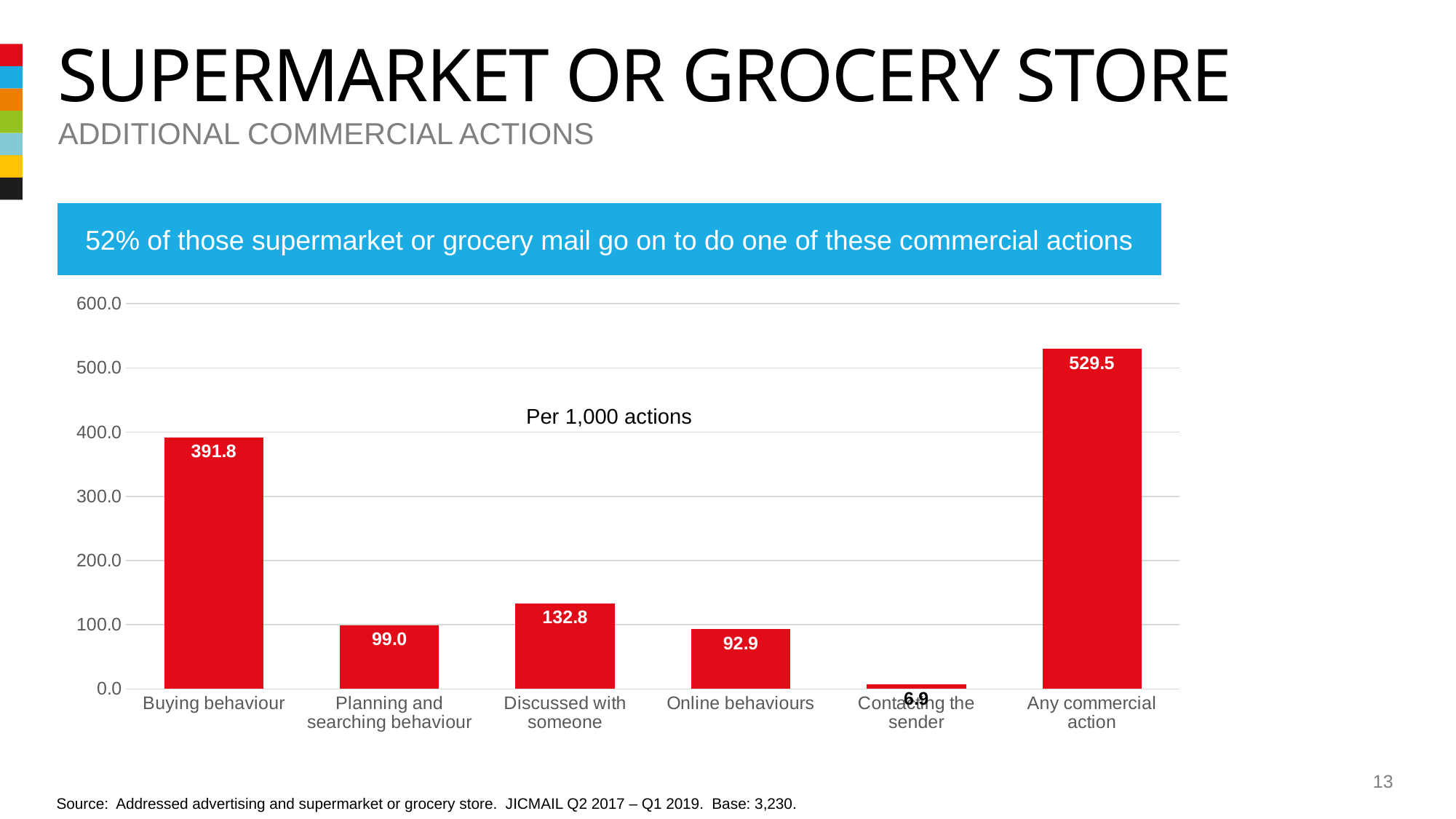
What is the value for Any commercial action? 529.5 What is the value for Buying behaviour? 391.8 What kind of chart is shown on the slide? Bar chart Which is larger, the value for Discussed with someone or the value for Online behaviours? Discussed with someone What is the value for Planning and searching behaviour? 99.0 Which category has the highest value? Any commercial action Which category has the lowest value? Contacting the sender How many categories are shown on the chart? 6 What is the difference between the values for Any commercial action and Buying behaviour? 137.7 What unit label is printed on the chart? Per 1,000 actions What is the value for Online behaviours? 92.9 What is the value for Discussed with someone? 132.8